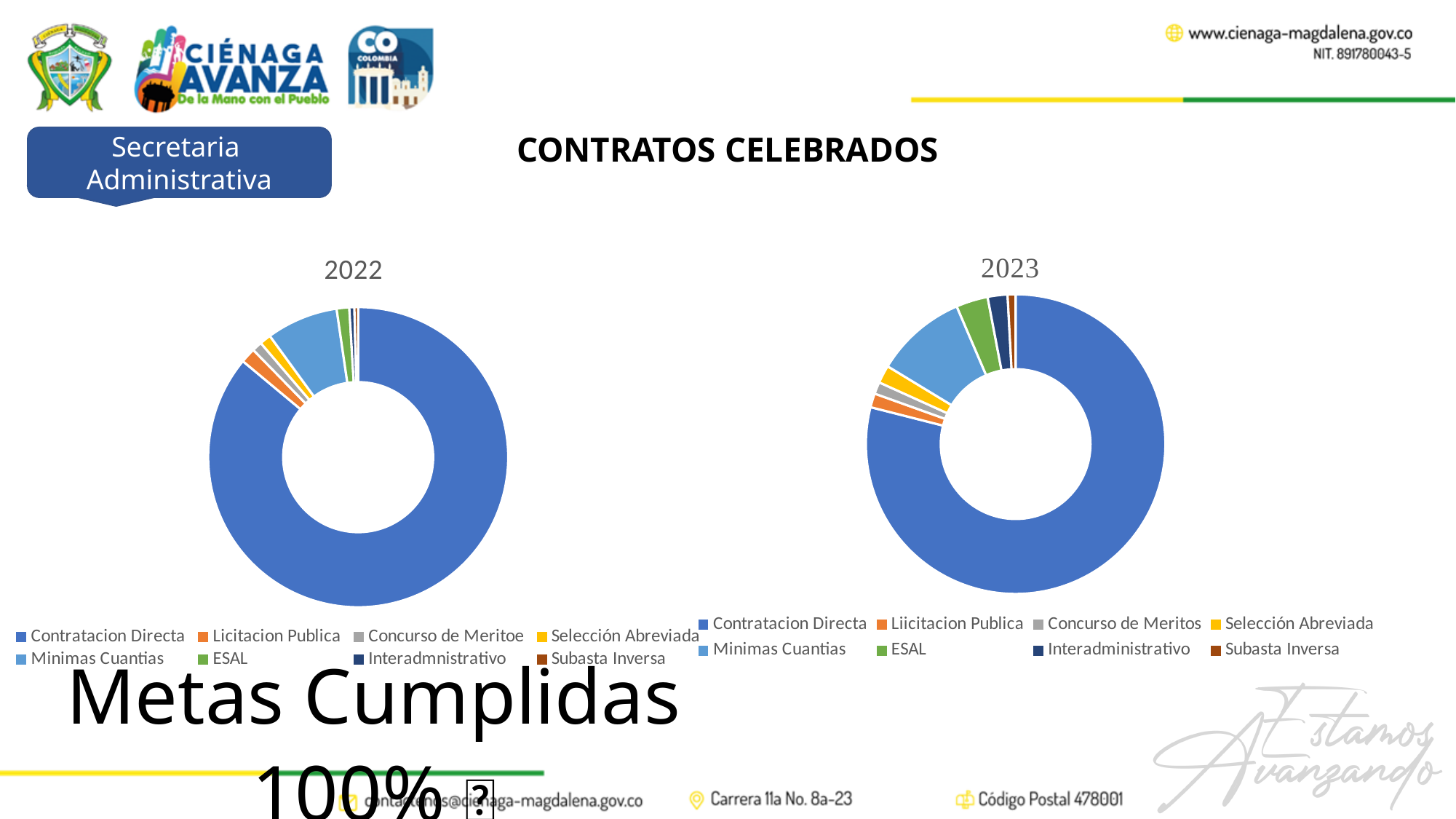
In the 2022 chart, which category has the largest slice? Contratacion Directa In the 2023 chart, which slice is larger, ESAL or Subasta Inversa? ESAL In the 2022 chart, which slice is larger, Contratacion Directa or Licitacion Publica? Contratacion Directa What colour represents Contratacion Directa in the 2023 chart? blue How many categories does the legend of the 2022 chart list? 8 What is the title shown above the two charts? CONTRATOS CELEBRADOS In the 2022 chart, which slice is larger, Contratacion Directa or Minimas Cuantias? Contratacion Directa In the 2023 chart, which category has the largest slice? Contratacion Directa What kind of chart is the 2022 chart? doughnut chart How many entries does the legend of the 2023 chart list? 8